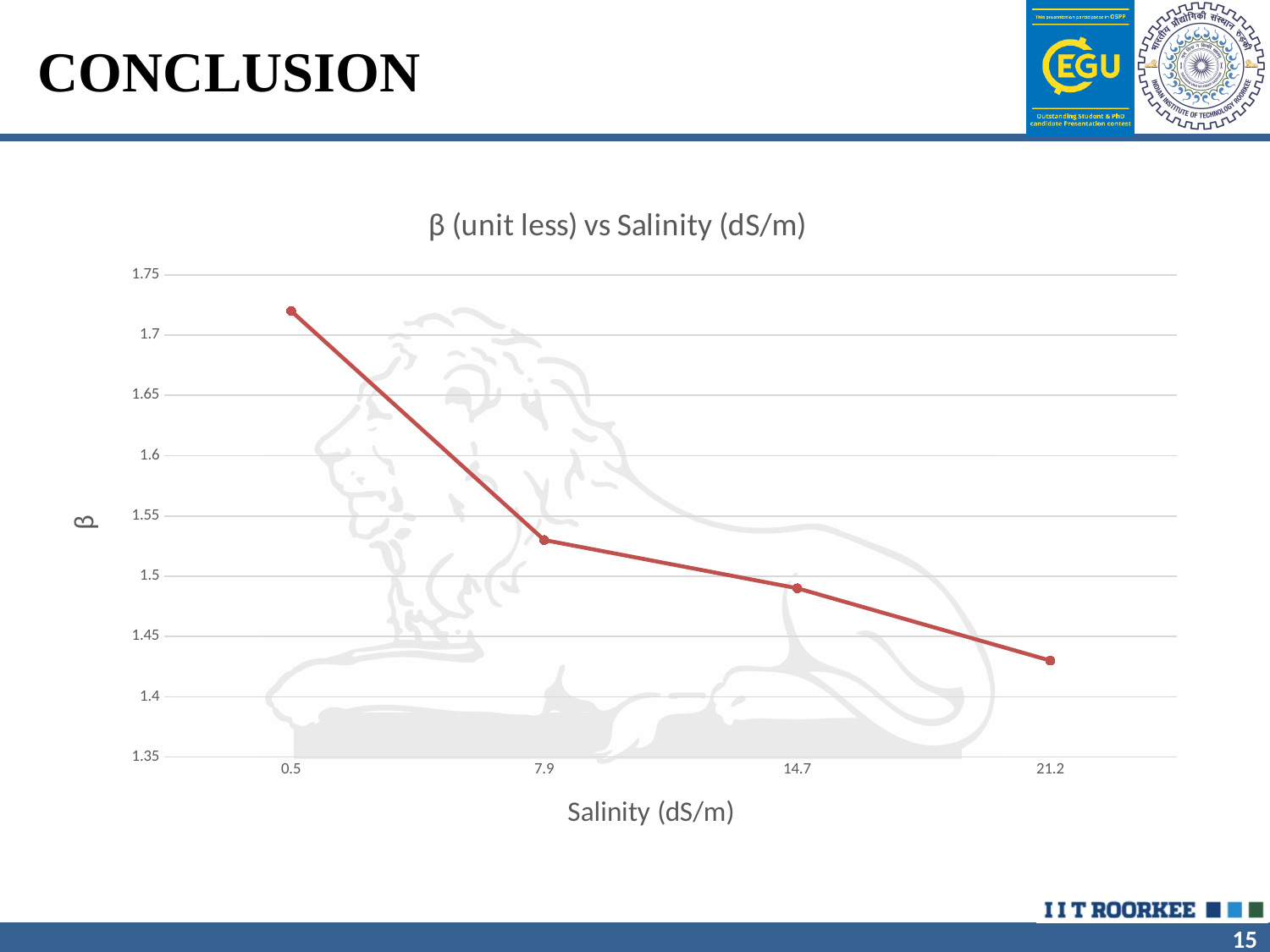
Does β rise or fall as salinity increases along the x axis? fall What is the label of the x axis? Salinity (dS/m) Is the value of β at salinity 21.2 greater or less than 1.45? less At which salinity value is β lowest? 21.2 Is the value of β at salinity 0.5 greater or less than 1.65? greater At which salinity value is β highest? 0.5 How many data points are plotted on the line? 4 What is the title of the chart? β (unit less) vs Salinity (dS/m) What kind of chart is shown on the slide? line chart Which has the larger β value: salinity 7.9 or salinity 21.2? 7.9 Is the value of β at salinity 14.7 greater or less than 1.55? less